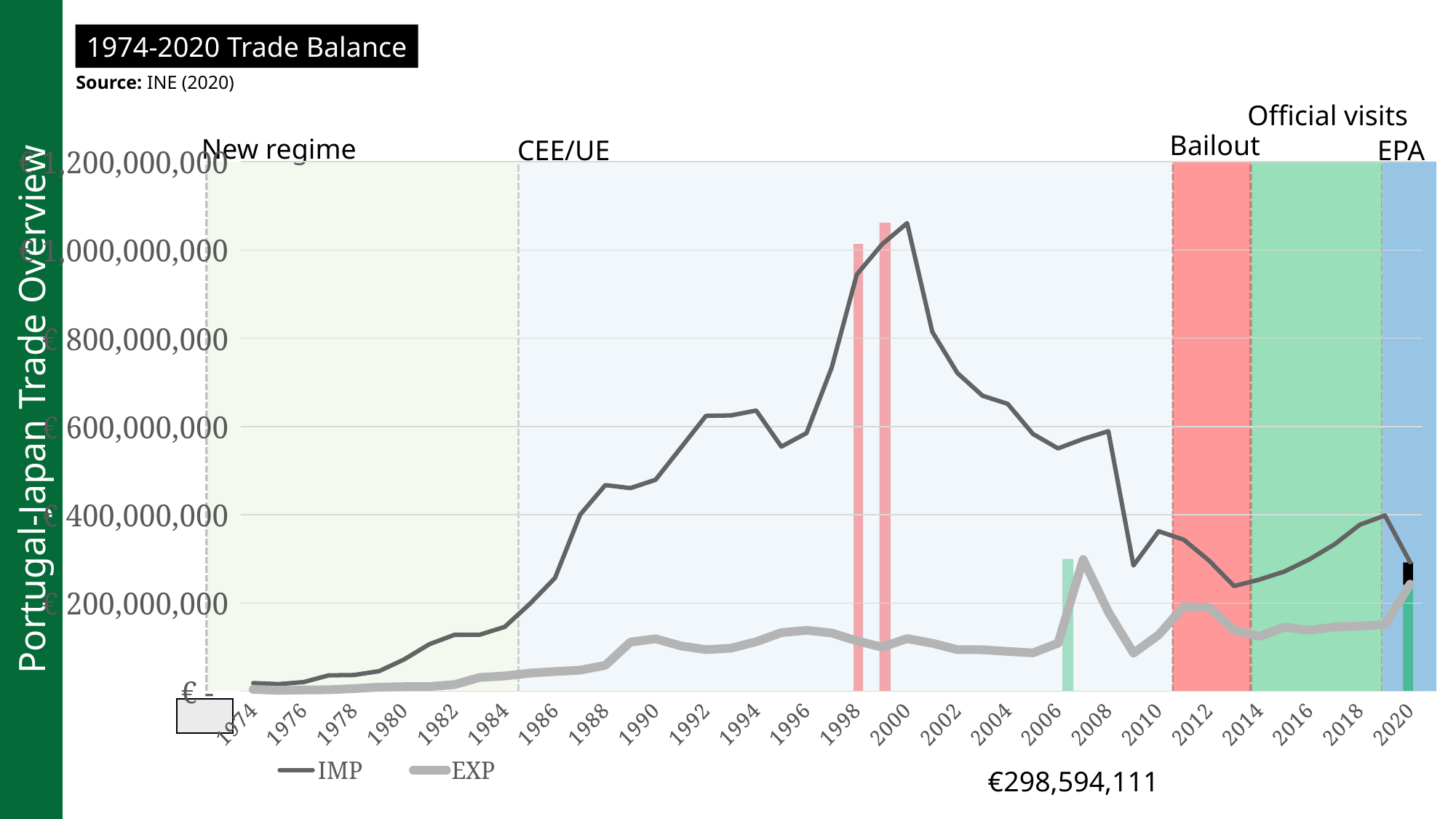
Which is larger, the IMP value for 1998 or the IMP value for 1980? 1998 What kind of chart is shown on the slide? line chart What is the title of the chart? 1974-2020 Trade Balance What are the two series named in the legend? IMP and EXP Does the IMP series rise or fall between 2002 and 2010? fall Is the IMP value for 1980 greater or less than 200,000,000? less In 2008, which series has the higher value, IMP or EXP? IMP Is the EXP value for 1990 greater or less than 200,000,000? less What value is printed as a data label on the chart? €298,594,111 Is the IMP value for 1998 greater or less than 800,000,000? greater How many series does the legend list? 2 Does the IMP series rise or fall between 1974 and 1986? rise